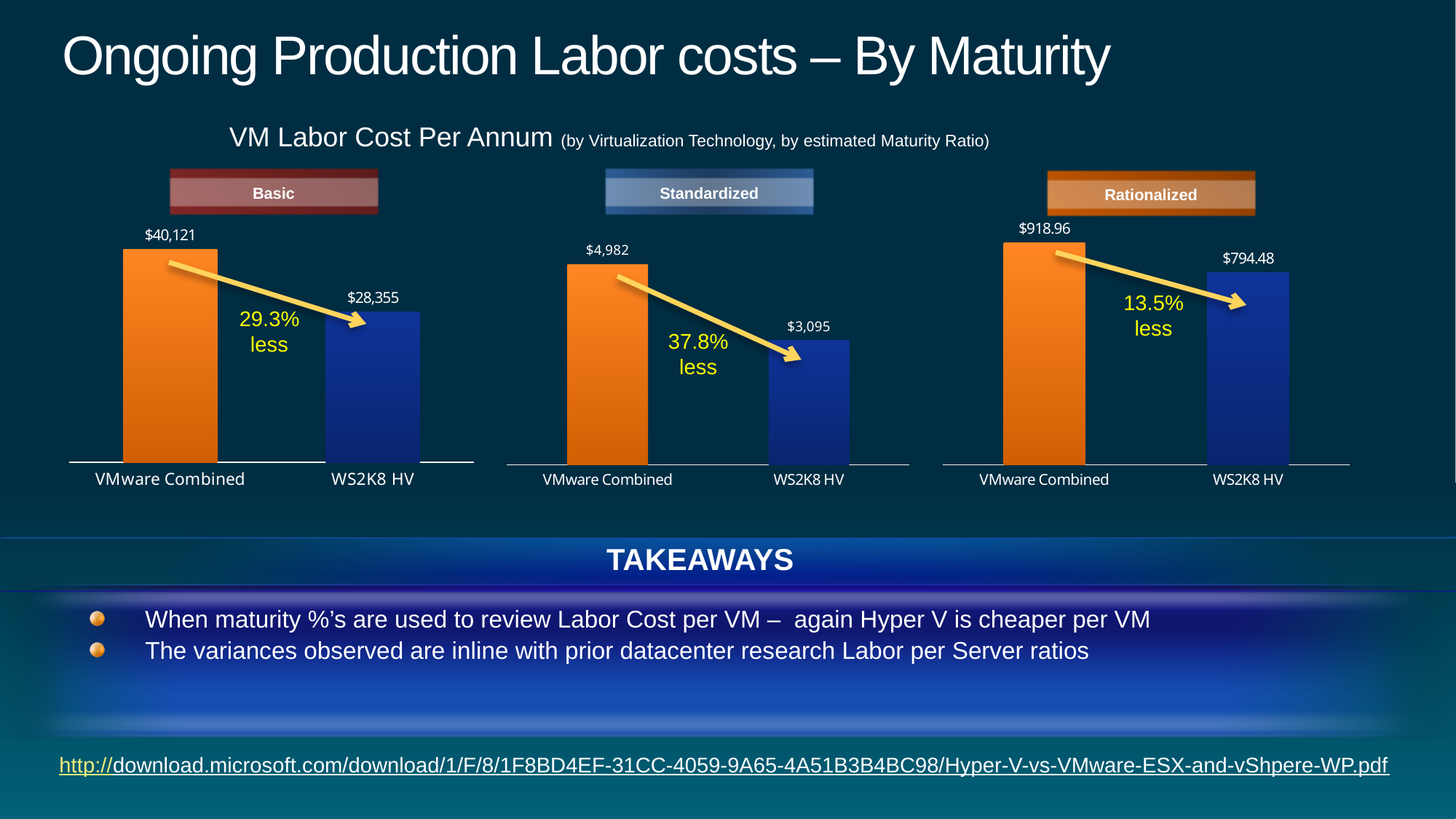
In the Standardized chart, what is the difference between the VMware Combined and WS2K8 HV values? $1,887 In the Basic chart, what is the VM labor cost per annum for VMware Combined? $40,121 In the Rationalized chart, what is the value for WS2K8 HV? $794.48 How many bars are shown in the Standardized chart? 2 In the Basic chart, what is the difference between the VMware Combined and WS2K8 HV values? $11,766 In the Rationalized chart, what is the difference between the VMware Combined and WS2K8 HV values? $124.48 In the Basic chart, what is the value for WS2K8 HV? $28,355 What type of chart is used for the Basic maturity level? Bar chart In the Standardized chart, what is the value for WS2K8 HV? $3,095 In the Standardized chart, what is the value for VMware Combined? $4,982 In the Rationalized chart, what is the value for VMware Combined? $918.96 In the Rationalized chart, which category has the higher value, VMware Combined or WS2K8 HV? VMware Combined